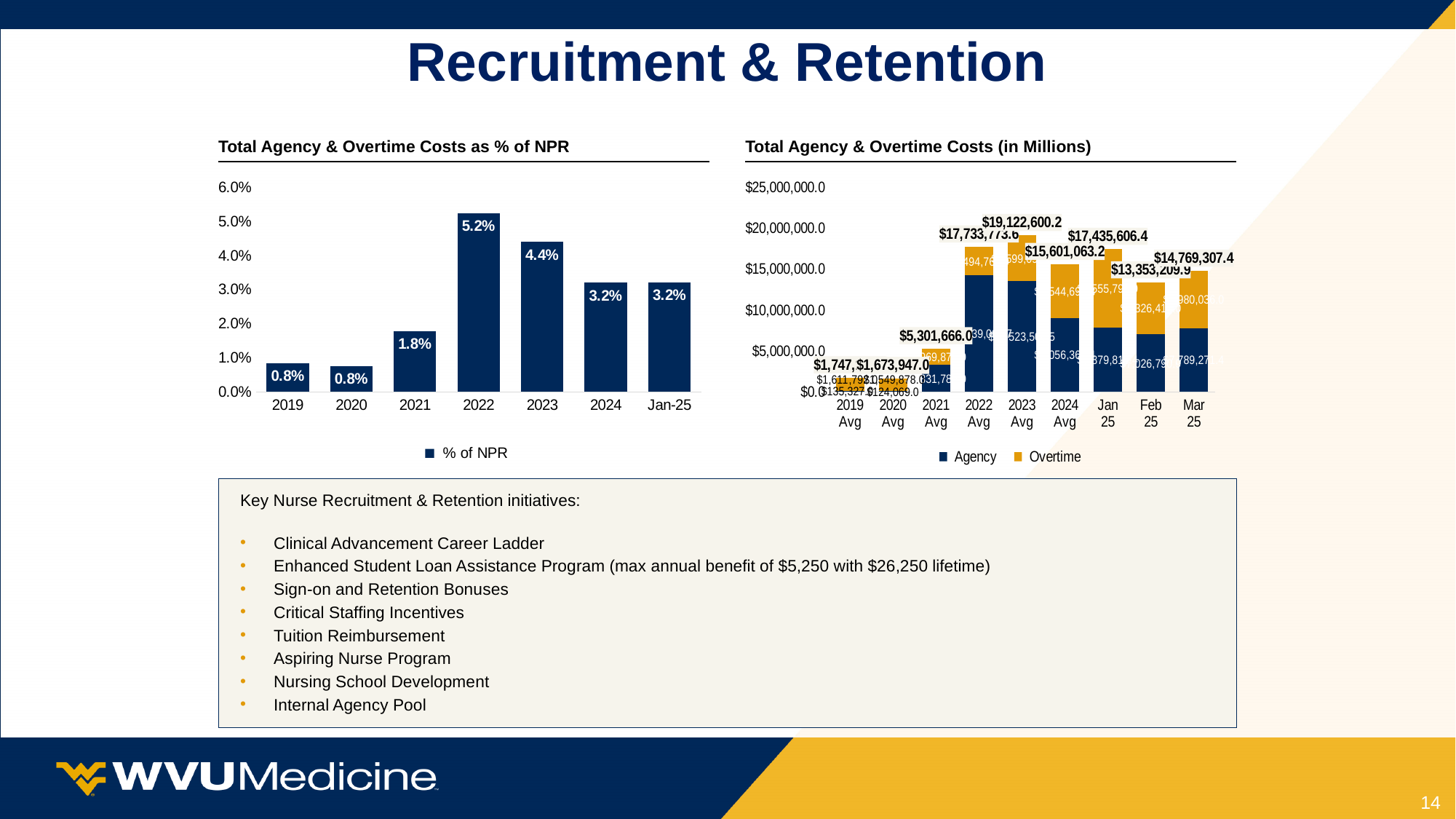
In the 'Total Agency & Overtime Costs (in Millions)' chart, what is the total labeled for Feb 25? $13,353,209.9 In the 'Total Agency & Overtime Costs (in Millions)' chart, which category has the highest total? 2023 Avg In the 'Total Agency & Overtime Costs as % of NPR' chart, which year has the highest value? 2022 What kind of chart is the 'Total Agency & Overtime Costs as % of NPR' chart? bar chart How many categories are shown on the x axis of the 'Total Agency & Overtime Costs as % of NPR' chart? 7 In the 'Total Agency & Overtime Costs as % of NPR' chart, what is the value for 2022? 5.2% In the 'Total Agency & Overtime Costs (in Millions)' chart, what is the total labeled for 2023 Avg? $19,122,600.2 In the 'Total Agency & Overtime Costs as % of NPR' chart, what is the difference between the 2022 and 2023 values? 0.8 percentage points In the 'Total Agency & Overtime Costs (in Millions)' chart, is the total for 2019 Avg greater or less than $5,000,000.0? less How many series does the legend of the 'Total Agency & Overtime Costs (in Millions)' chart list? 2 In the 'Total Agency & Overtime Costs as % of NPR' chart, what is the value for 2021? 1.8% In the 'Total Agency & Overtime Costs as % of NPR' chart, which is larger, the value for 2023 or the value for 2024? 2023